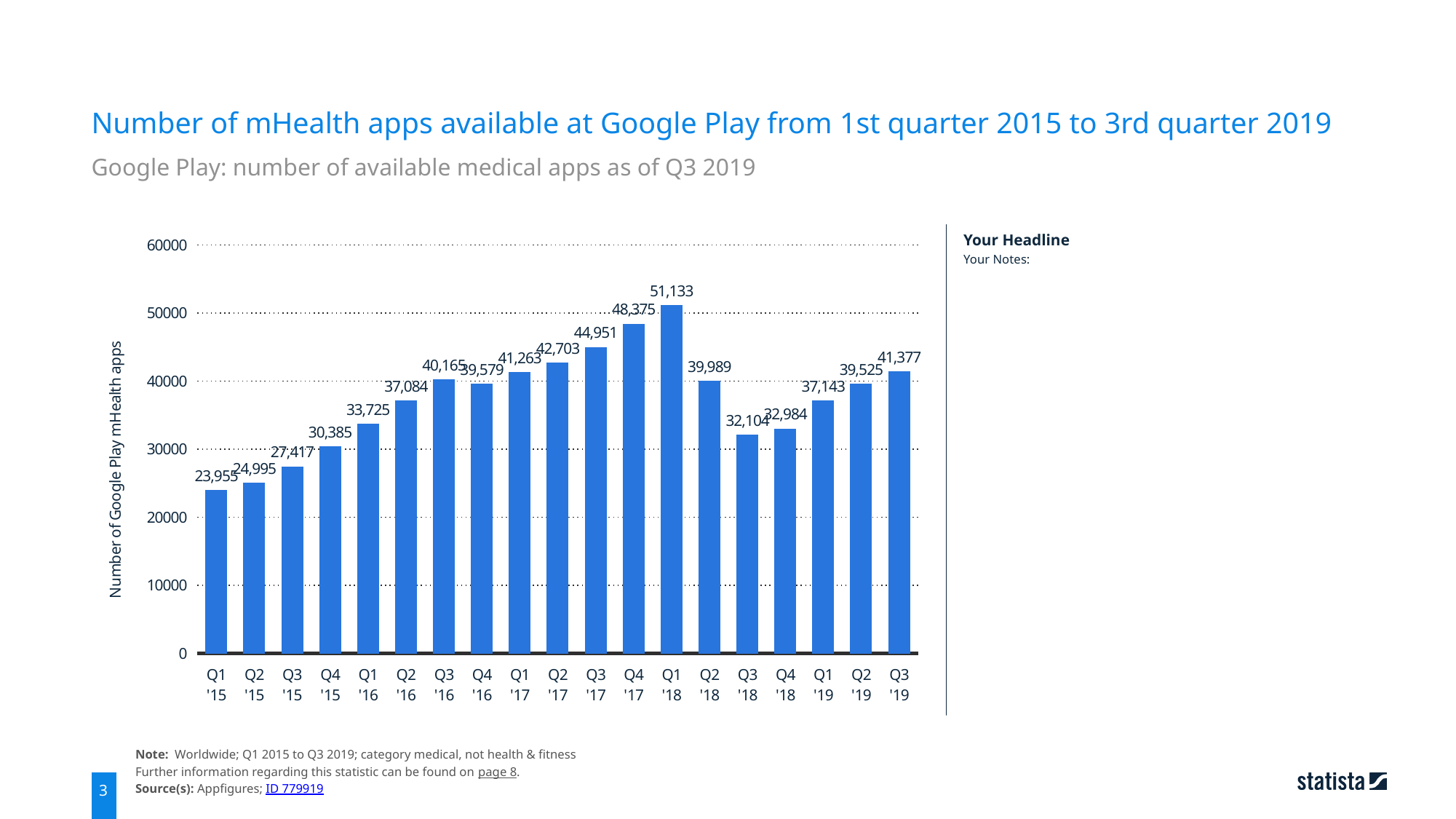
What is the number of Google Play mHealth apps in Q3 '19? 41,377 How many quarters are shown on the x axis? 19 What is the difference between the number of mHealth apps in Q3 '19 and Q1 '15? 17,422 What kind of chart is shown on the slide? Bar chart Which quarter has the lowest number of Google Play mHealth apps? Q1 '15 What is the label of the y axis? Number of Google Play mHealth apps What is the number of Google Play mHealth apps in Q1 '15? 23,955 Which quarter has the highest number of Google Play mHealth apps? Q1 '18 What is the number of Google Play mHealth apps in Q1 '18? 51,133 What is the difference between the number of mHealth apps in Q1 '18 and Q2 '18? 11,144 Is the value for Q4 '17 greater or less than 40000? greater Which quarter has more mHealth apps, Q3 '18 or Q1 '19? Q1 '19